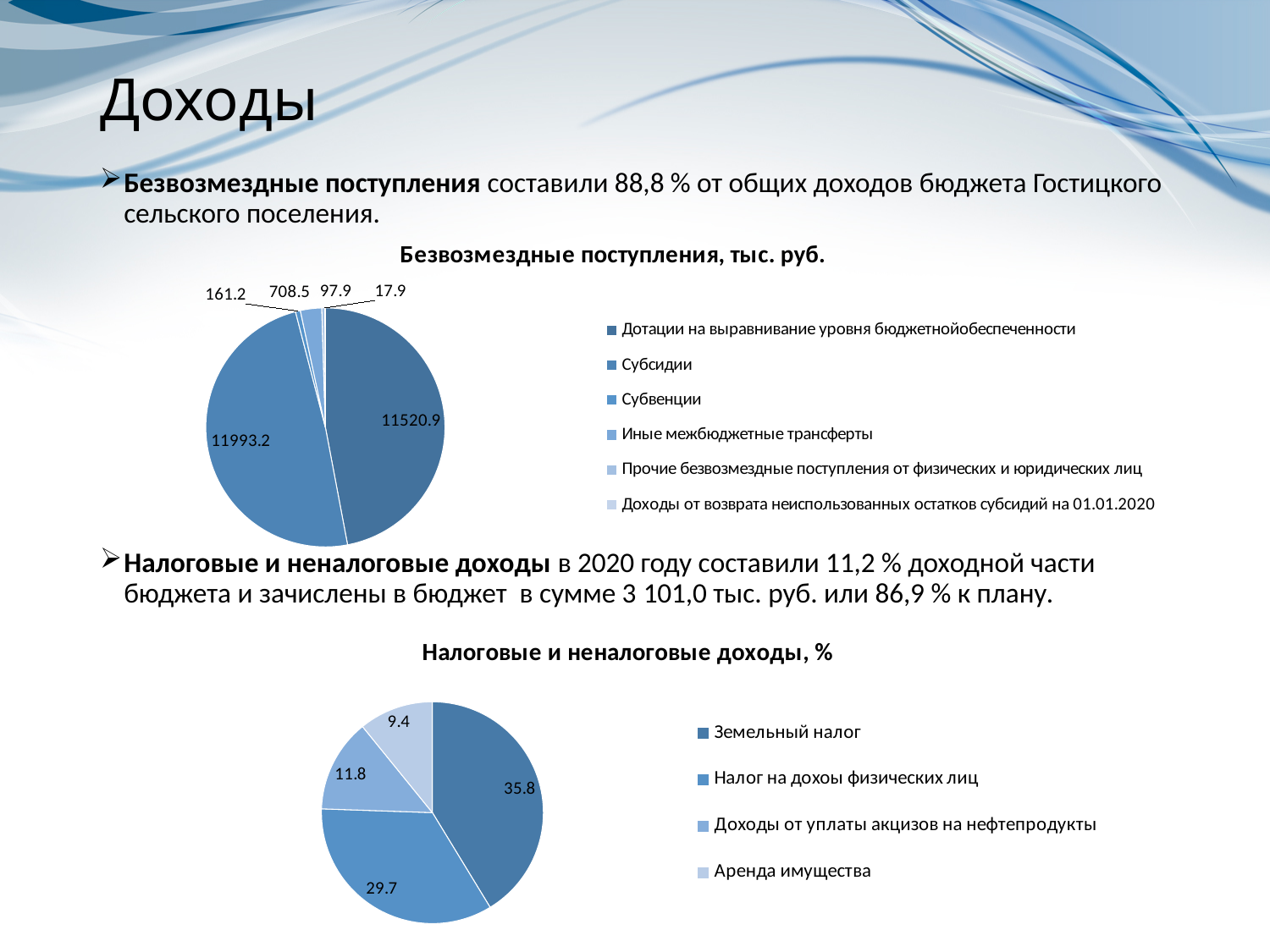
In the chart "Безвозмездные поступления, тыс. руб.", what is the value for "Дотации на выравнивание уровня бюджетной обеспеченности"? 11520.9 In the chart "Безвозмездные поступления, тыс. руб.", what is the difference between the values for "Субсидии" and "Дотации на выравнивание уровня бюджетной обеспеченности"? 472.3 In the chart "Налоговые и неналоговые доходы, %", what is the value for "Аренда имущества"? 9.4 In the chart "Безвозмездные поступления, тыс. руб.", what is the smallest value shown on a slice? 17.9 In the chart "Безвозмездные поступления, тыс. руб.", how many entries does the legend list? 6 In the chart "Налоговые и неналоговые доходы, %", how many slices does the pie have? 4 In the chart "Безвозмездные поступления, тыс. руб.", which category has the largest value? Субсидии In the chart "Безвозмездные поступления, тыс. руб.", what is the value for "Субсидии"? 11993.2 In the chart "Безвозмездные поступления, тыс. руб.", which is larger: "Дотации на выравнивание уровня бюджетной обеспеченности" or "Субсидии"? Субсидии In the chart "Налоговые и неналоговые доходы, %", what is the value for "Земельный налог"? 35.8 What kind of chart is the chart titled "Безвозмездные поступления, тыс. руб."? pie chart In the chart "Налоговые и неналоговые доходы, %", what is the difference between "Земельный налог" and "Налог на доходы физических лиц"? 6.1